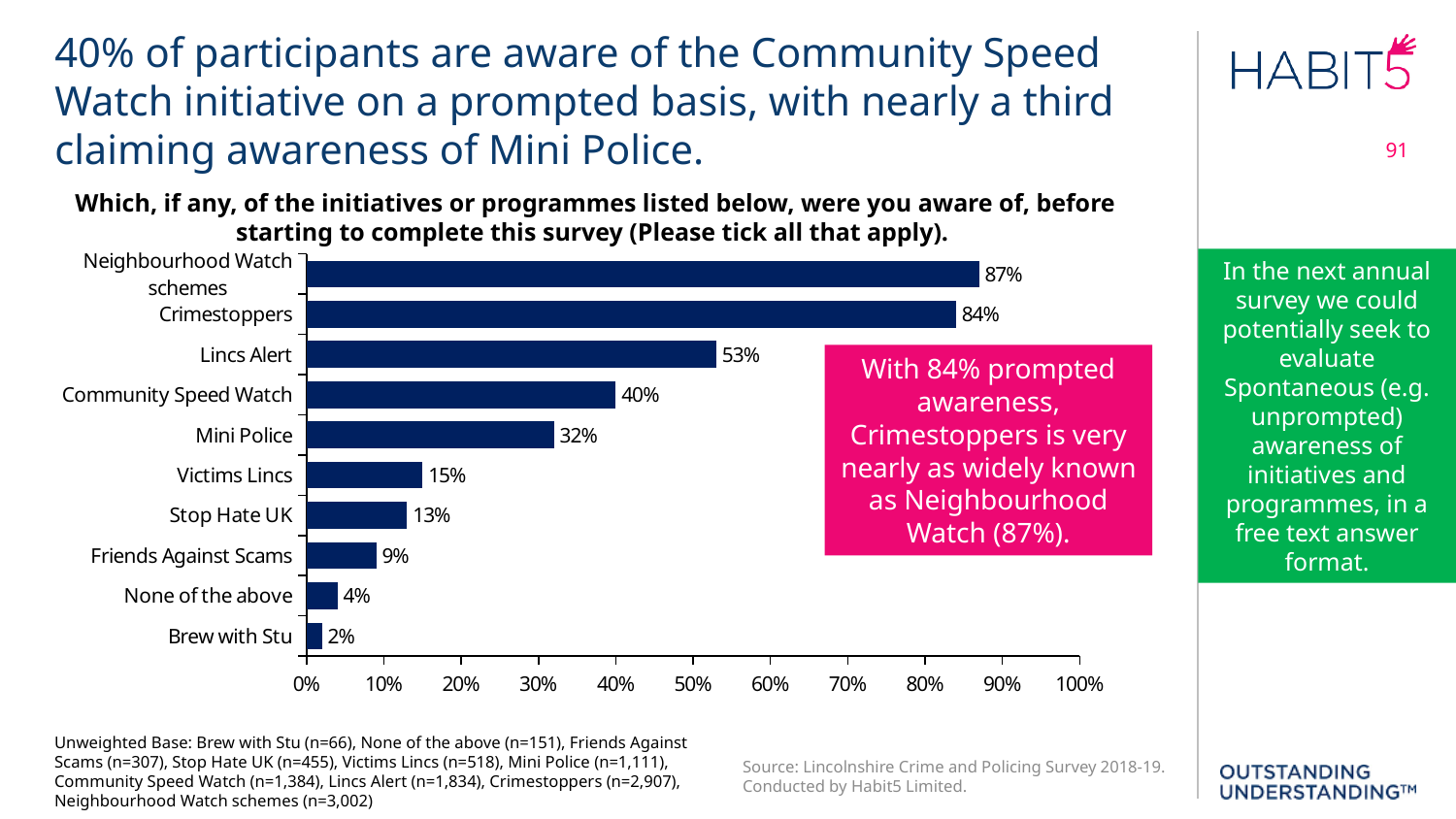
Which initiative has the lowest prompted awareness? Brew with Stu Which has higher awareness, Victims Lincs or Friends Against Scams? Victims Lincs What kind of chart is shown on the slide? Bar chart What is the maximum value shown on the horizontal axis? 100% Which initiative has the highest prompted awareness? Neighbourhood Watch schemes What percentage of participants were aware of Stop Hate UK? 13% How many categories are shown in the chart? 10 Is the value for Lincs Alert greater or less than 50%? greater What percentage of participants were aware of Community Speed Watch? 40% What is the difference in awareness between Neighbourhood Watch schemes and Crimestoppers? 3% What percentage of participants were aware of Lincs Alert? 53% What is the difference in awareness between Community Speed Watch and Mini Police? 8%